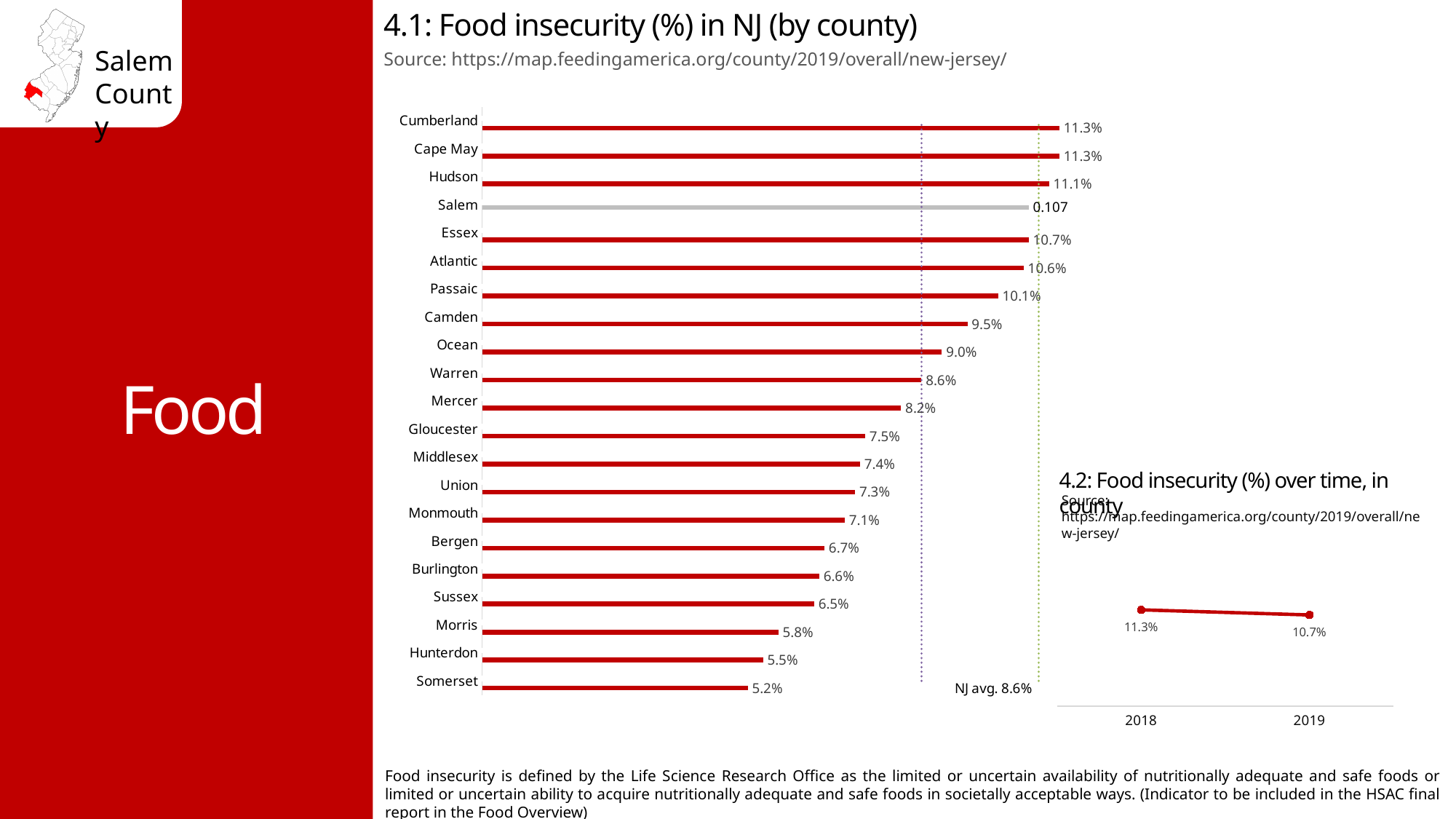
In the chart '4.2: Food insecurity (%) over time, in county', what is the value for 2018? 11.3% In the chart '4.1: Food insecurity (%) in NJ (by county)', which county has the lowest food insecurity? Somerset In the chart '4.1: Food insecurity (%) in NJ (by county)', which is larger, the value for Ocean or the value for Mercer? Ocean What kind of chart is '4.1: Food insecurity (%) in NJ (by county)'? Bar chart In the chart '4.1: Food insecurity (%) in NJ (by county)', what is the value for Camden? 9.5% In the chart '4.1: Food insecurity (%) in NJ (by county)', what is the difference between Essex and Somerset? 5.5% In the chart '4.2: Food insecurity (%) over time, in county', what is the difference between the 2018 and 2019 values? 0.6% In the chart '4.2: Food insecurity (%) over time, in county', does the value rise or fall from 2018 to 2019? Fall In the chart '4.1: Food insecurity (%) in NJ (by county)', what is the data label shown for Salem? 0.107 In the chart '4.1: Food insecurity (%) in NJ (by county)', what NJ average value is labelled? 8.6% In the chart '4.1: Food insecurity (%) in NJ (by county)', what is the value for Hudson? 11.1% How many counties are shown in the chart '4.1: Food insecurity (%) in NJ (by county)'? 21